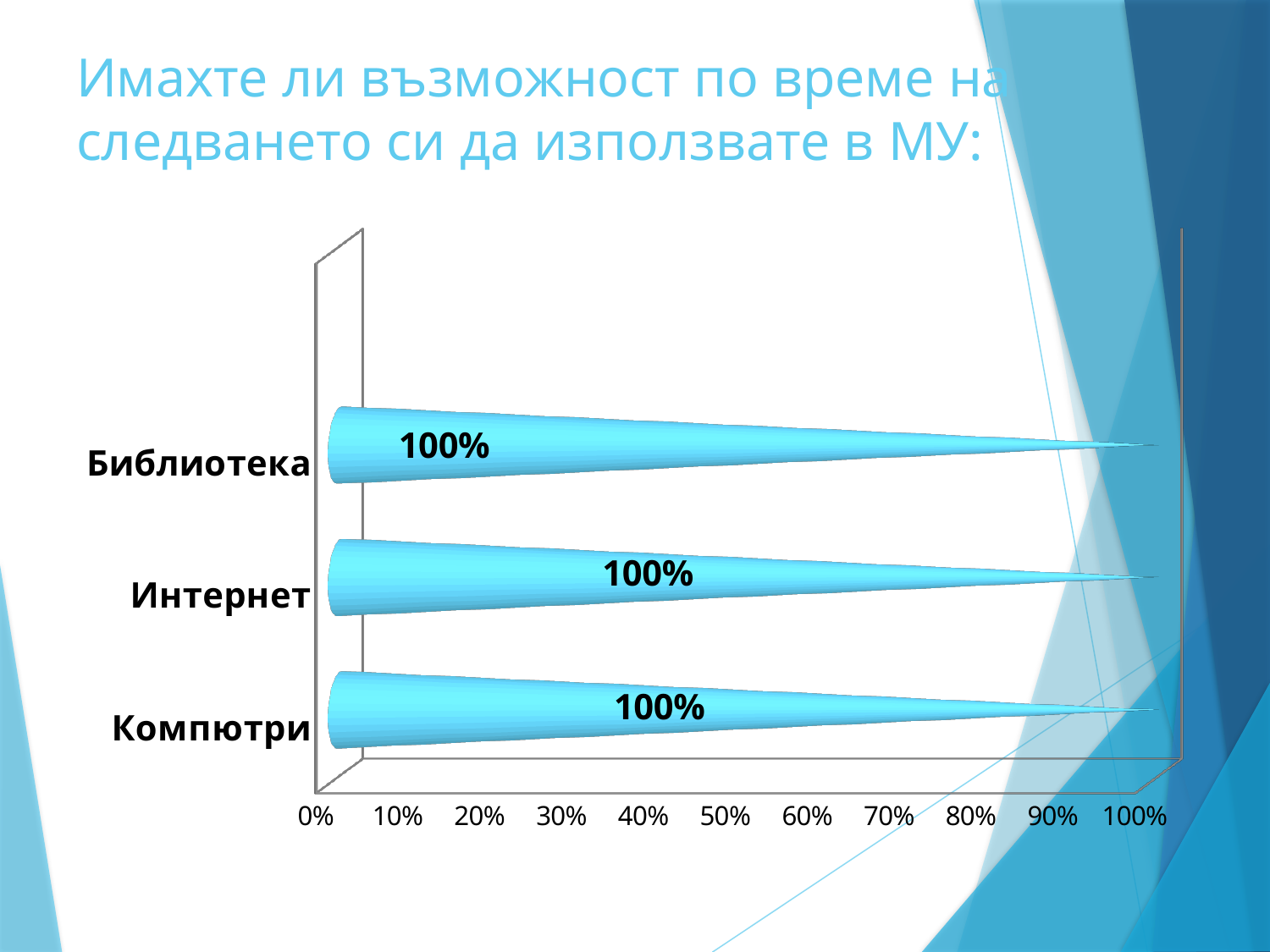
What is the title of the slide containing the chart? Имахте ли възможност по време на следването си да използвате в МУ: What is the value for Интернет? 100% Do all three categories have the same value? Yes Is the value for Компютри greater or less than 90%? greater What is the difference between the values for Библиотека and Компютри? 0% What is the value for Компютри? 100% Is the value for Интернет greater or less than 50%? greater What is the value for Библиотека? 100% What is the highest value shown on the horizontal axis? 100% What kind of chart is shown on the slide? bar chart How many categories are shown on the chart? 3